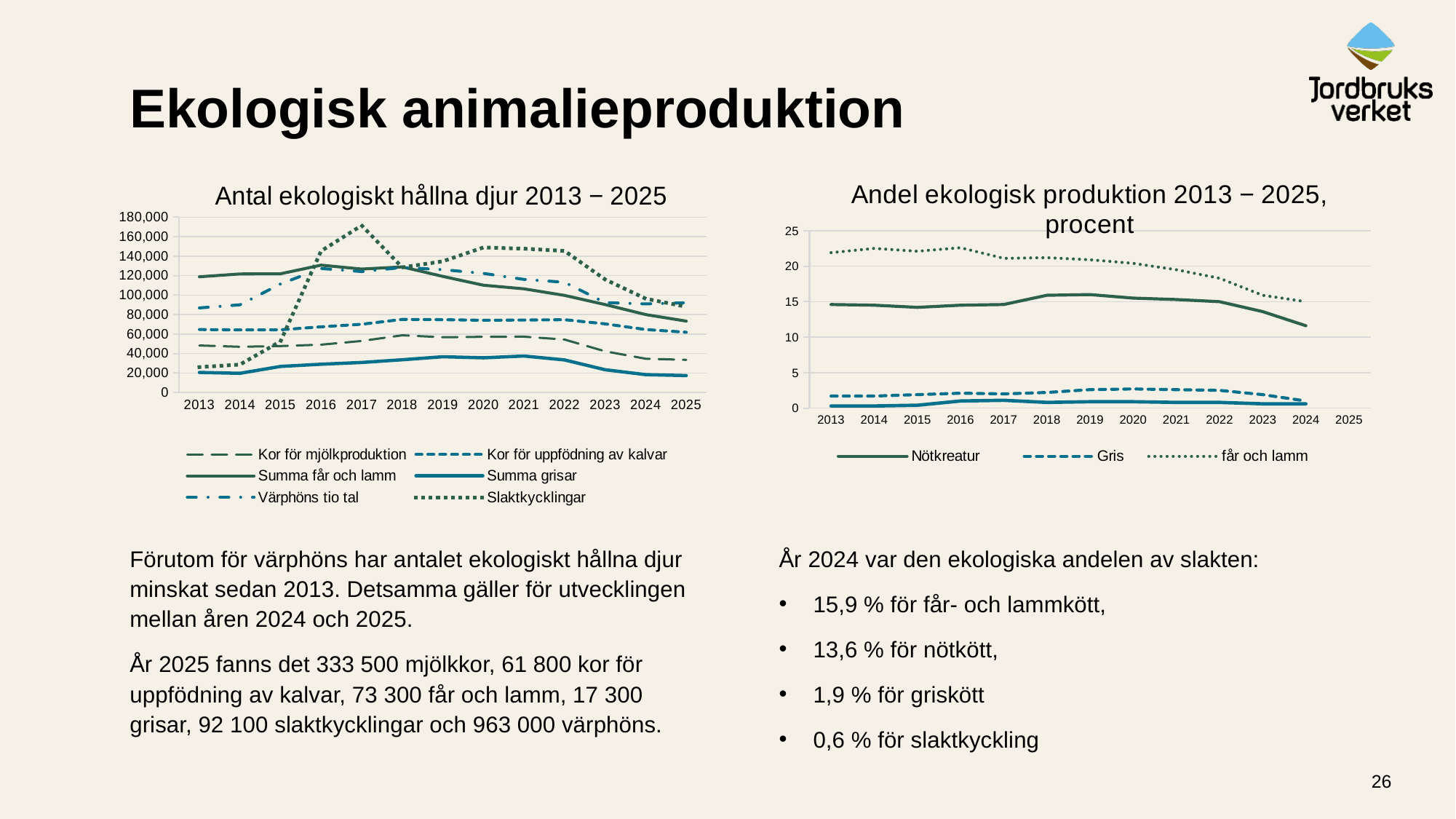
In the left chart 'Antal ekologiskt hållna djur 2013 − 2025', is the value for Slaktkycklingar in 2017 greater or less than 160,000? greater How many years are shown on the x axis of the left chart 'Antal ekologiskt hållna djur 2013 − 2025'? 13 In the right chart 'Andel ekologisk produktion 2013 − 2025, procent', is the value for Nötkreatur in 2024 greater or less than 15? less In the left chart 'Antal ekologiskt hållna djur 2013 − 2025', which series has the lowest values across the whole period? Summa grisar In the left chart 'Antal ekologiskt hållna djur 2013 − 2025', is the value for Summa grisar in 2025 greater or less than 20,000? less How many series does the legend of the right chart 'Andel ekologisk produktion 2013 − 2025, procent' list? 3 In the right chart 'Andel ekologisk produktion 2013 − 2025, procent', which is larger in 2020: Nötkreatur or Gris? Nötkreatur In the right chart 'Andel ekologisk produktion 2013 − 2025, procent', which series has the highest values throughout the period? får och lamm How many series does the legend of the left chart 'Antal ekologiskt hållna djur 2013 − 2025' list? 6 In the left chart 'Antal ekologiskt hållna djur 2013 − 2025', does the Summa får och lamm series rise or fall between 2018 and 2025? fall In the left chart 'Antal ekologiskt hållna djur 2013 − 2025', in which year does the Slaktkycklingar series reach its highest value? 2017 What type of chart is the left chart titled 'Antal ekologiskt hållna djur 2013 − 2025'? line chart